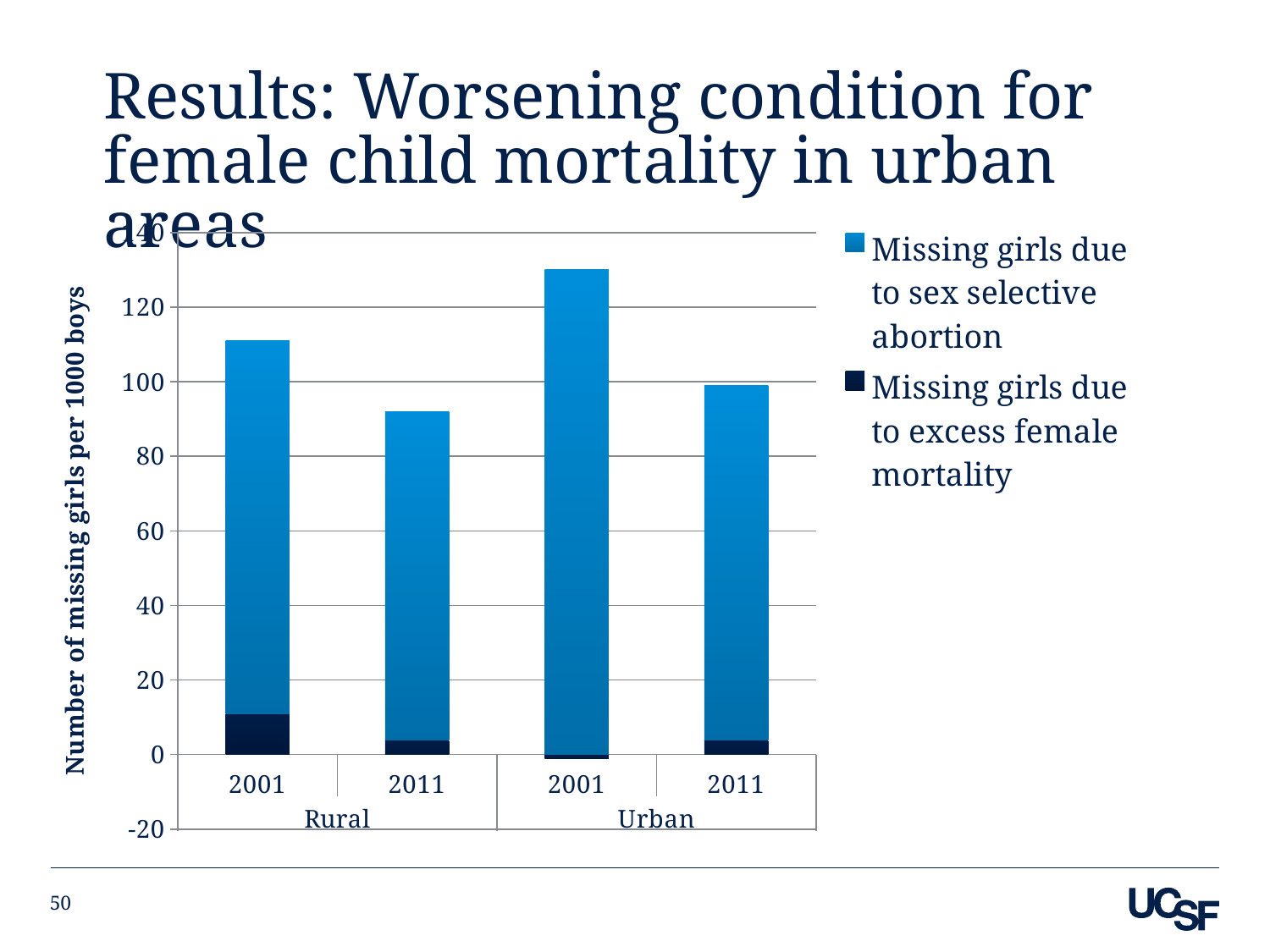
How many series does the legend list? 2 What is the title of the vertical axis? Number of missing girls per 1000 boys Which bar has the lowest total number of missing girls per 1000 boys? Rural 2011 Is the total value for Rural 2011 greater or less than 100? less How many bars are plotted in the chart? 4 Which bar has the highest total number of missing girls per 1000 boys? Urban 2001 What kind of chart is shown on the slide? Stacked bar chart Which legend entry is shown in the dark navy colour? Missing girls due to excess female mortality In rural areas, does the total number of missing girls rise or fall from 2001 to 2011? Fall Is the total value for Rural 2001 greater or less than 100? greater Is the total value for Urban 2001 greater or less than 120? greater Which is larger, the total for Rural 2001 or the total for Urban 2001? Urban 2001